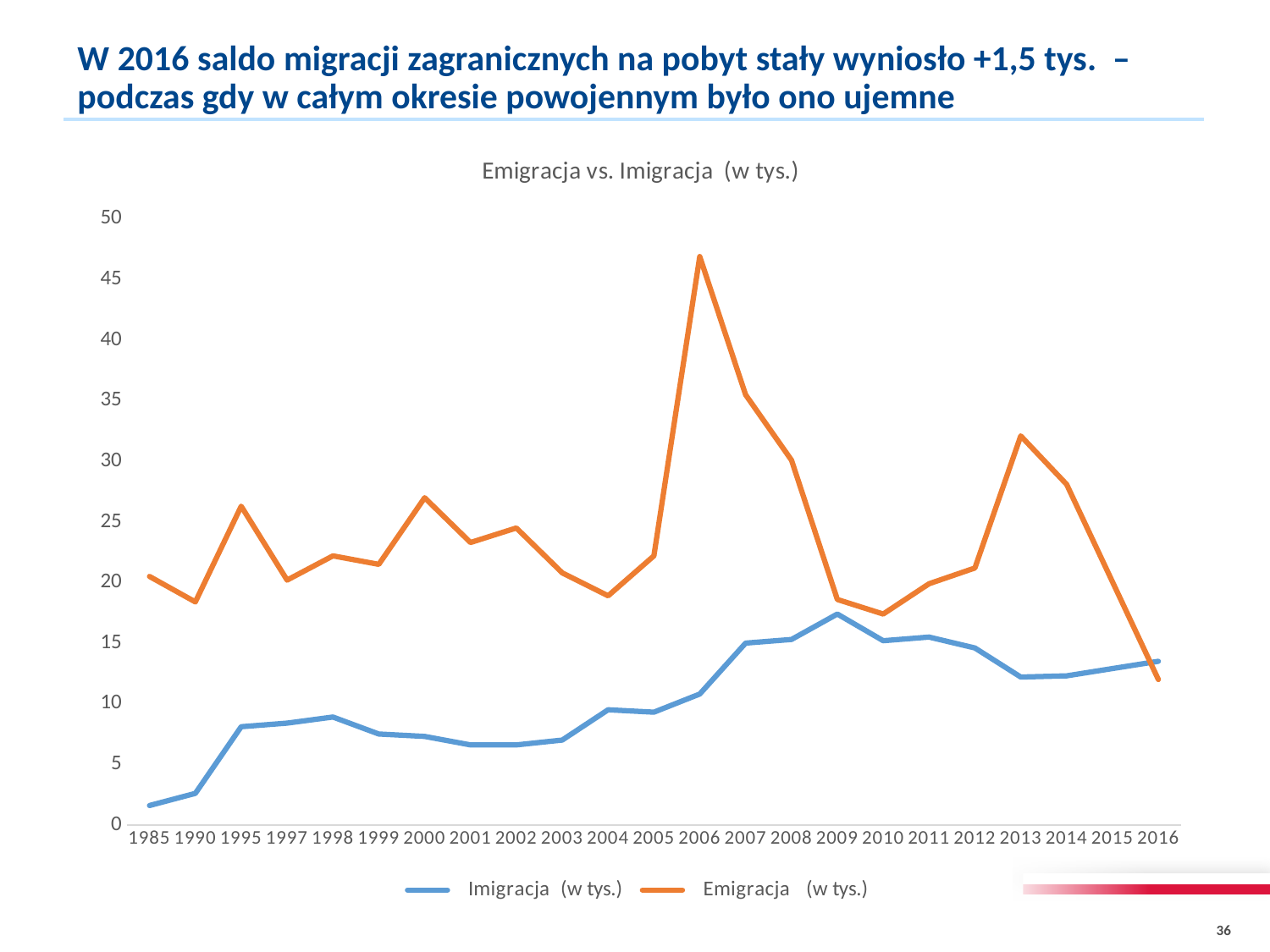
How many years are plotted along the x axis? 23 What is the title of the chart? Emigracja vs. Imigracja (w tys.) What kind of chart is shown on the slide? line chart Which series has the larger value in 2016, Imigracja (w tys.) or Emigracja (w tys.)? Imigracja (w tys.) Does the Emigracja (w tys.) series rise or fall from 2013 to 2016? fall In which year is the Imigracja (w tys.) series at its lowest? 1985 Is the value for Emigracja (w tys.) in 2013 greater or less than 30? greater Is the value for Emigracja (w tys.) in 2006 greater or less than 45? greater In which year does the Emigracja (w tys.) series reach its highest value? 2006 Which series has the larger value in 2009, Imigracja (w tys.) or Emigracja (w tys.)? Emigracja (w tys.) How many series does the legend list? 2 Is the value for Imigracja (w tys.) in 1985 greater or less than 5? less